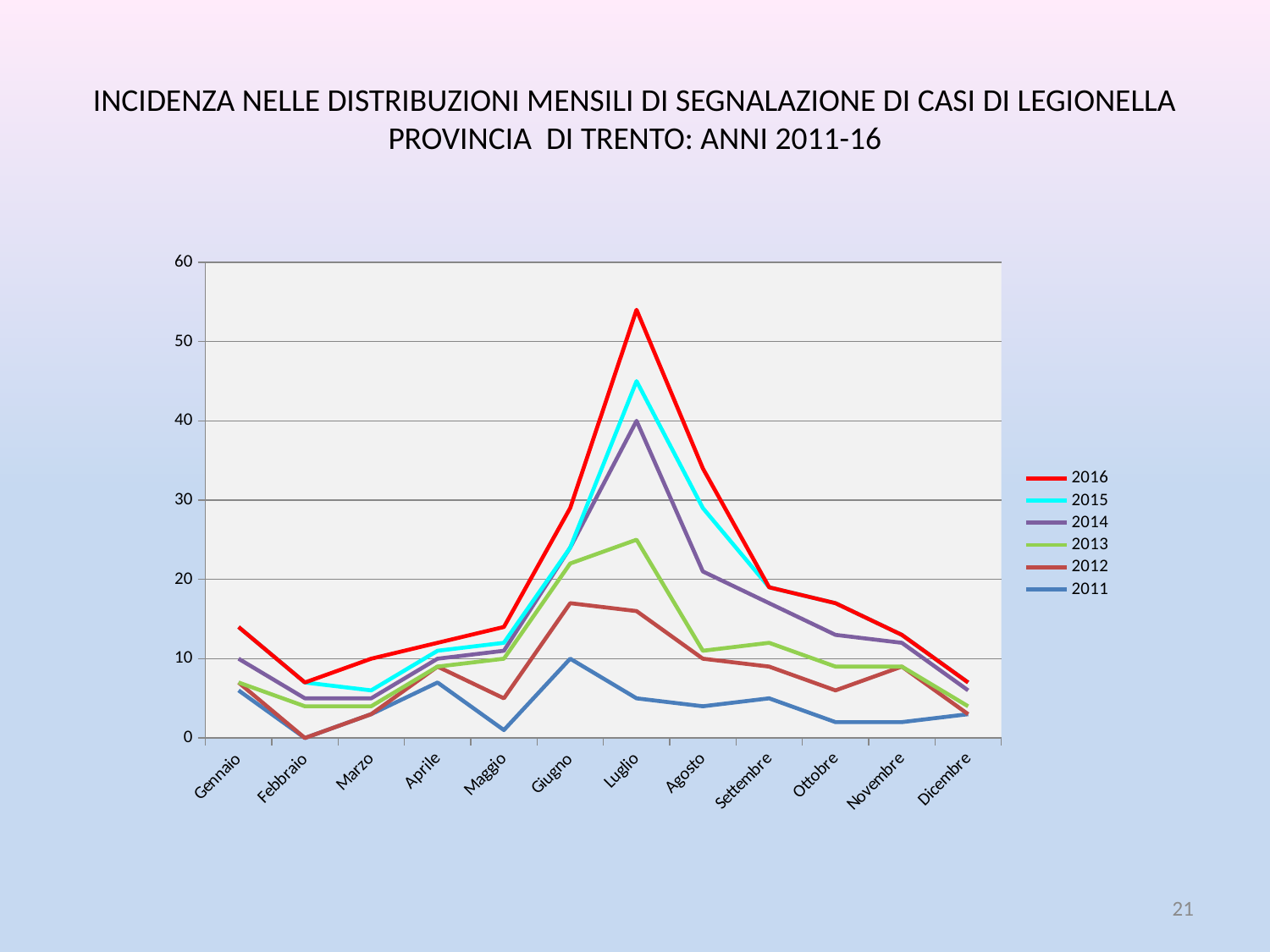
Does the 2016 series rise or fall from Luglio to Dicembre? fall Is the value for 2016 in Luglio greater or less than 50? greater What is the value for 2012 in Febbraio? 0 Is the value for 2013 in Luglio greater or less than 30? less In which month does the 2016 series reach its highest value? Luglio What kind of chart is shown on the slide? line chart Is the value for 2015 in Luglio greater or less than 40? greater How many series does the legend list? 6 In which month does the 2012 series reach its lowest value? Febbraio In Luglio, which series has the larger value, 2016 or 2015? 2016 How many months are shown along the x axis? 12